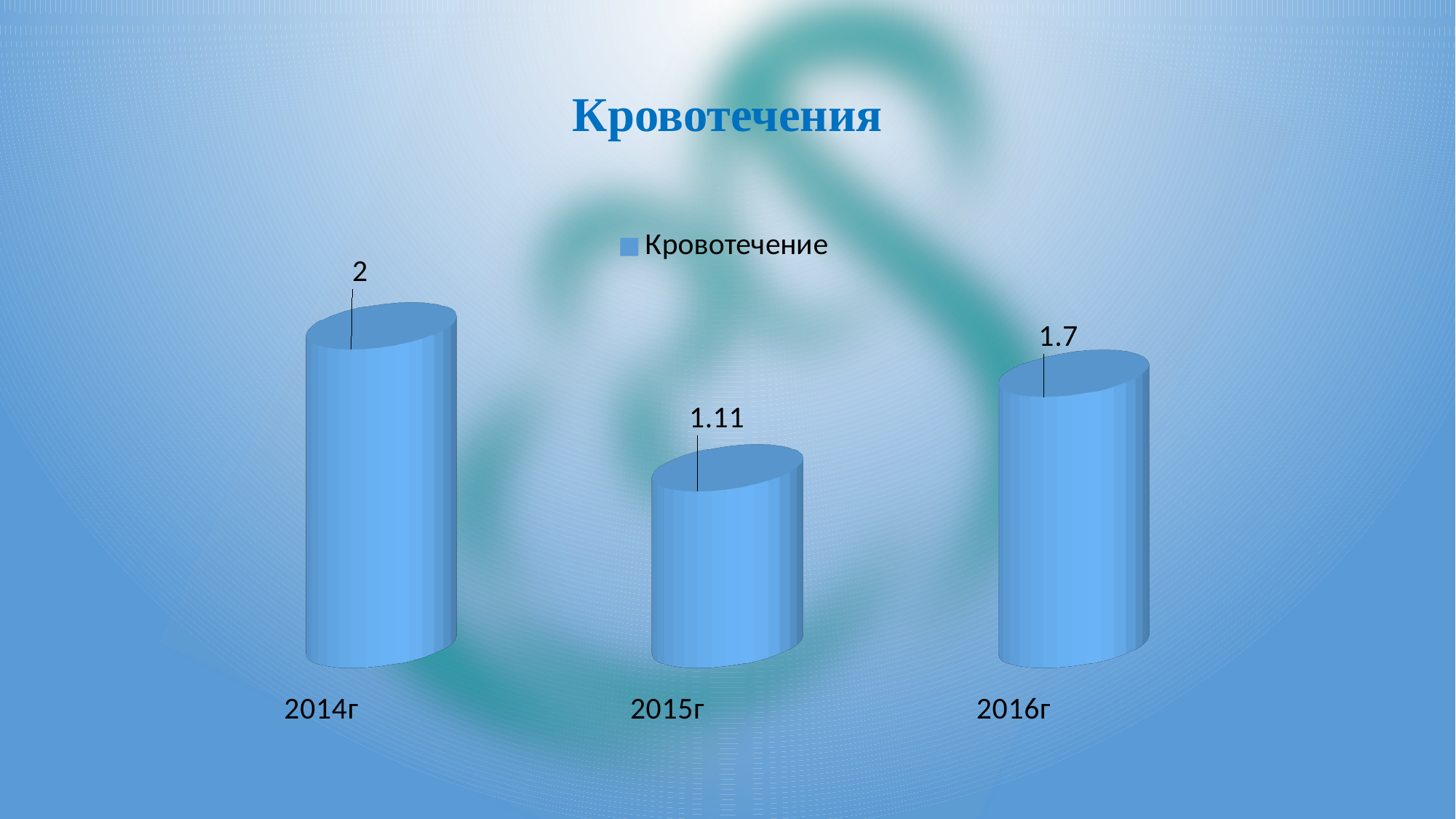
What is the difference between the values for 2016г and 2015г? 0.59 Which year has the lowest value? 2015г What is the value for 2014г? 2 What is the difference between the values for 2014г and 2015г? 0.89 How many series does the legend list? 1 Which year has the highest value? 2014г What kind of chart is shown? bar chart What is the value for 2015г? 1.11 What is the title of the chart? Кровотечения Which is larger, the value for 2016г or the value for 2015г? 2016г How many years are shown on the chart? 3 What is the value for 2016г? 1.7